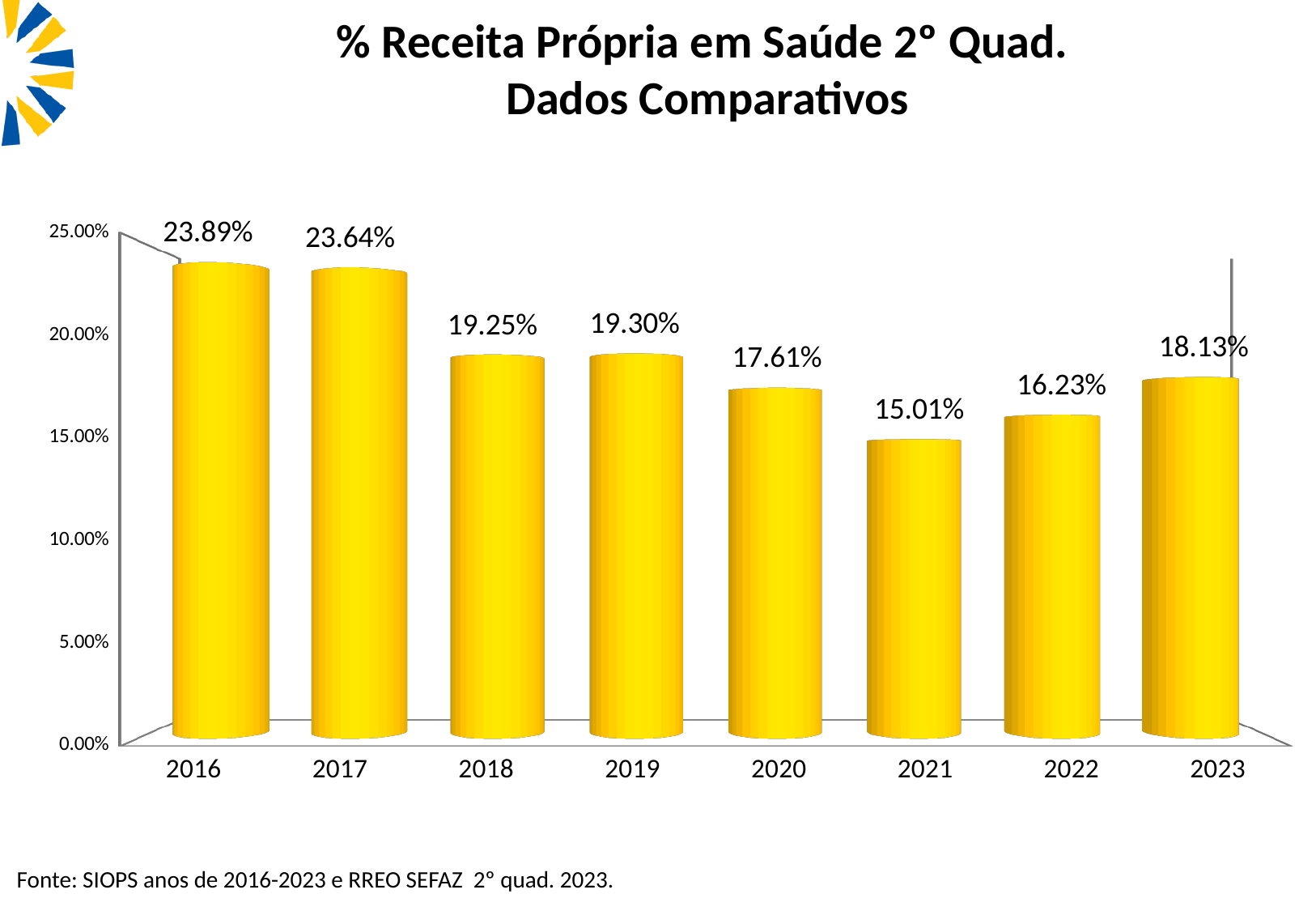
What is the value for 2016? 23.89% What is the difference between the values for 2016 and 2021? 8.88% Is the value for 2022 greater or less than 15.00%? greater Which is larger, the value for 2018 or the value for 2020? 2018 What is the value for 2023? 18.13% What is the value for 2021? 15.01% Which year has the lowest value? 2021 How many years are shown on the x axis? 8 What is the title of the chart? % Receita Própria em Saúde 2° Quad. Dados Comparativos Which year has the highest value? 2016 What kind of chart is this? bar chart Do the values generally rise or fall from 2016 to 2021? fall